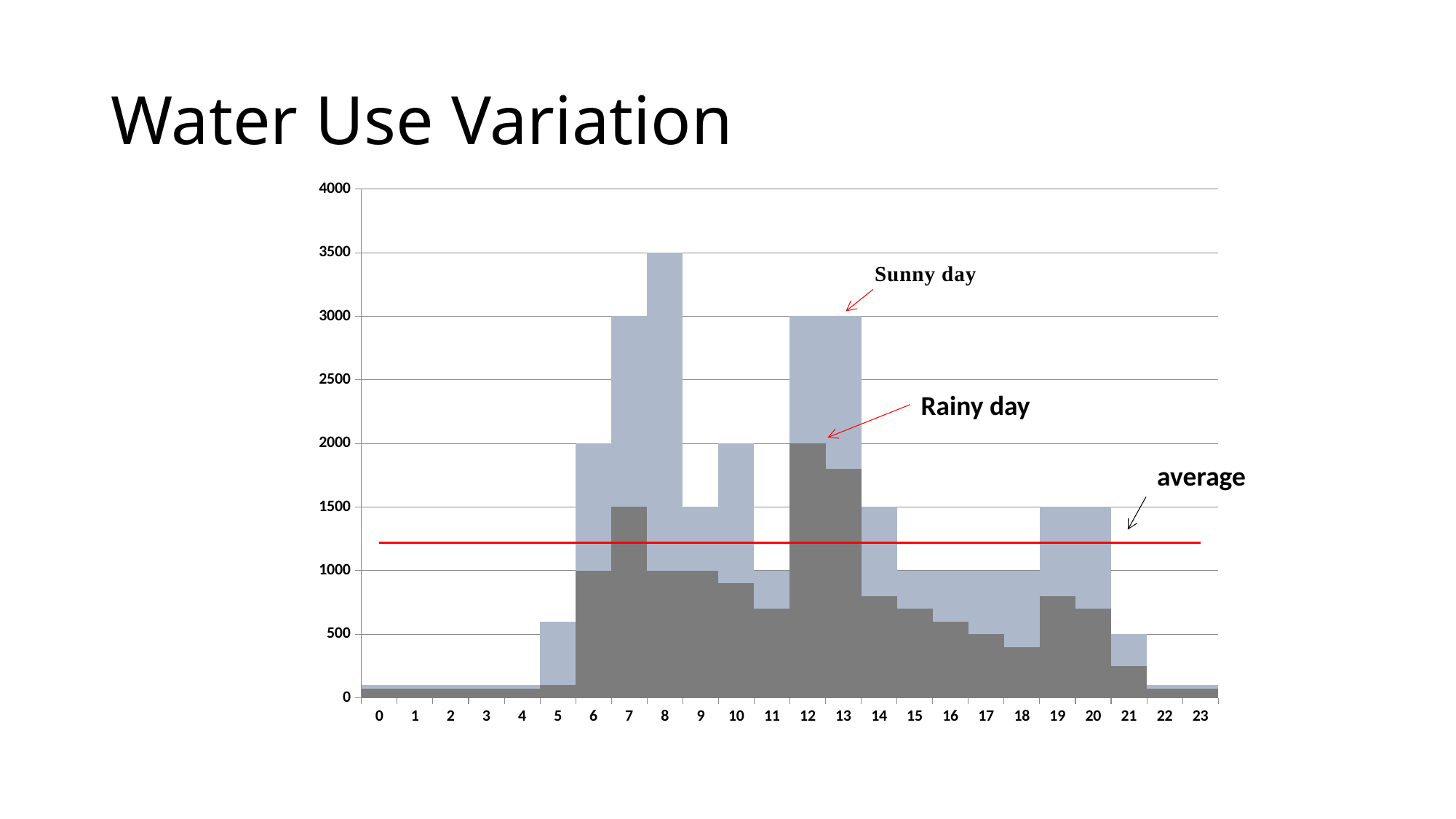
How many hours (categories) are shown along the x axis? 24 What kind of chart is shown on the slide? bar chart What is the difference between the Sunny day values at hour 8 and hour 7? 500 At which hour does the Rainy day series reach its highest value? 12 What is the Sunny day value at hour 8? 3500 Is the Rainy day value at hour 13 greater or less than 1500? greater What is the title of the slide? Water Use Variation At which hour does the Sunny day series reach its highest value? 8 Do the Sunny day values rise or fall from hour 13 to hour 18? fall What is the Rainy day value at hour 12? 2000 Is the Rainy day value at hour 18 greater or less than 500? less Which is larger, the Sunny day value at hour 8 or the Sunny day value at hour 12? hour 8